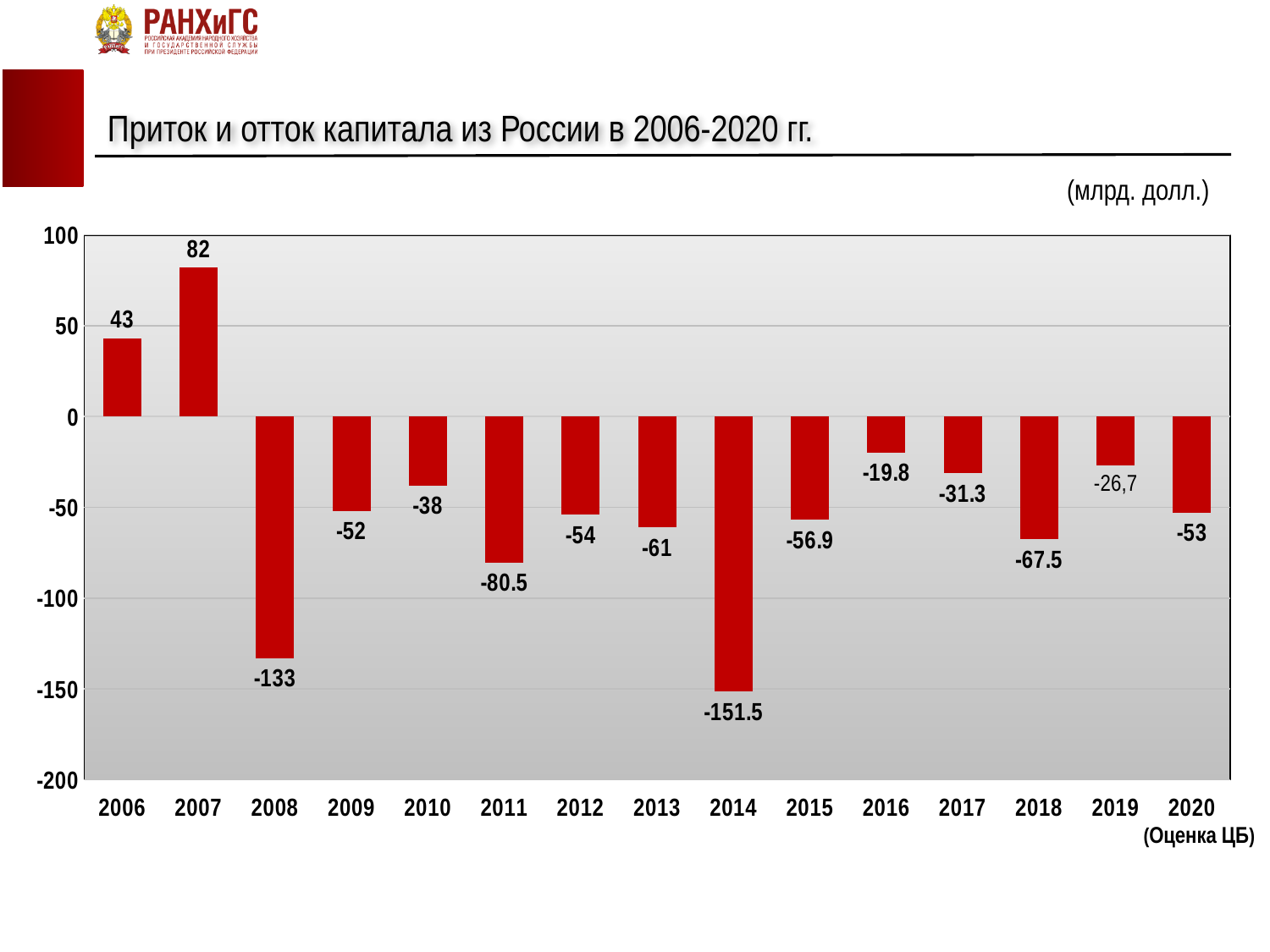
Which year has the highest value? 2007 How many years are shown on the x axis? 15 Is the value for 2008 greater or less than -100? less What is the value for 2019? -26,7 What unit is indicated for the values on the chart? млрд. долл. What is the value for 2014? -151.5 Which year has the lowest value? 2014 What kind of chart is shown on the slide? bar chart What is the value for 2007? 82 What is the title of the chart? Приток и отток капитала из России в 2006-2020 гг. What is the difference between the values for 2007 and 2006? 39 Which is larger, the value for 2016 or the value for 2017? 2016